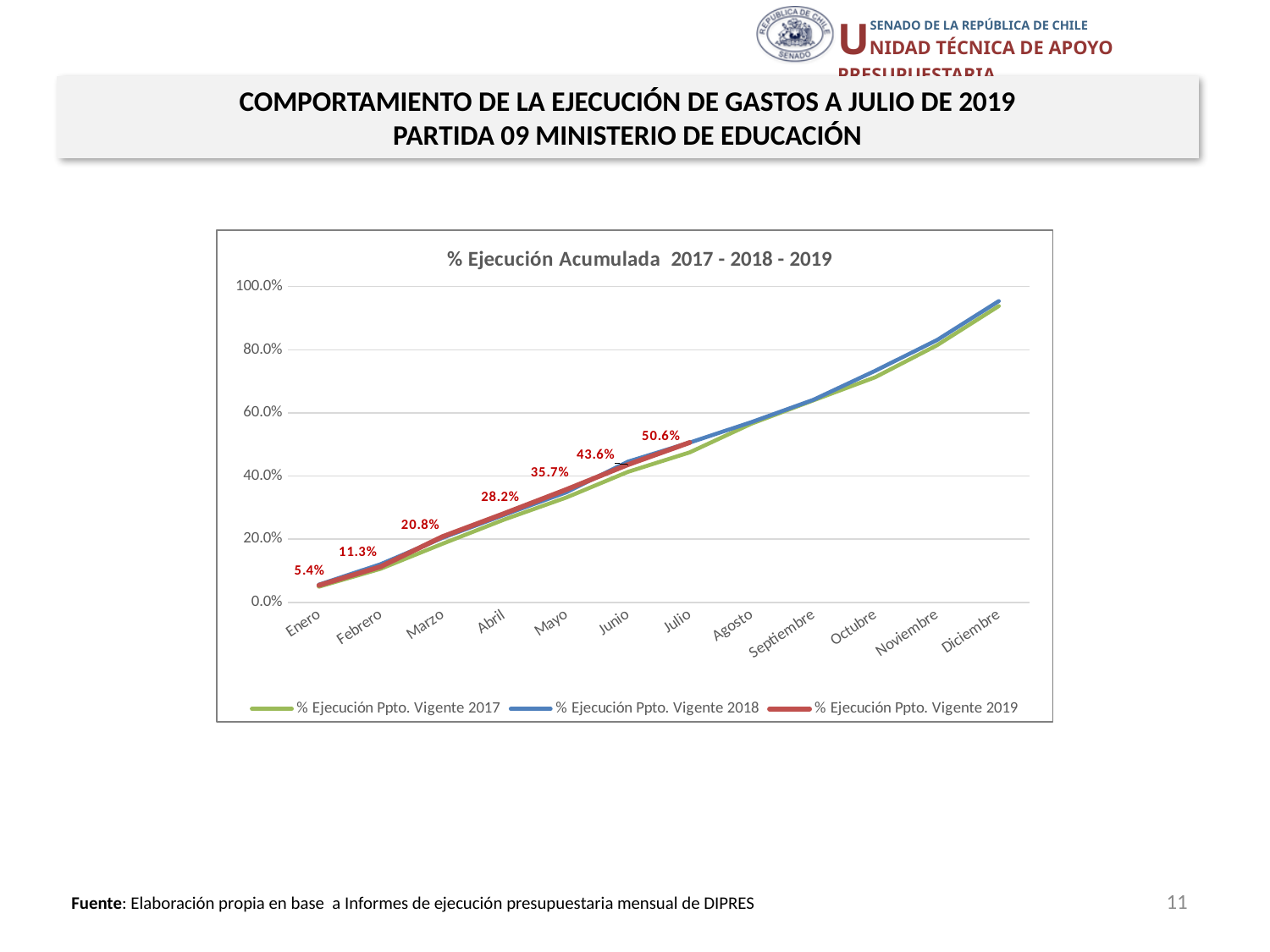
What is the difference between the 2019 values for Julio and Junio? 7.0% What is the value for % Ejecución Ppto. Vigente 2019 in Abril? 28.2% How many months are shown on the x axis? 12 What kind of chart is shown on the slide? Line chart Which month has the highest value for % Ejecución Ppto. Vigente 2019? Julio Which month has the lowest value for % Ejecución Ppto. Vigente 2019? Enero What is the value for % Ejecución Ppto. Vigente 2019 in Enero? 5.4% What is the value for % Ejecución Ppto. Vigente 2019 in Mayo? 35.7% What is the difference between the 2019 values for Marzo and Febrero? 9.5% How many series does the legend list? 3 Is the value for % Ejecución Ppto. Vigente 2018 in Diciembre greater or less than 80.0%? greater What is the value for % Ejecución Ppto. Vigente 2019 in Julio? 50.6%